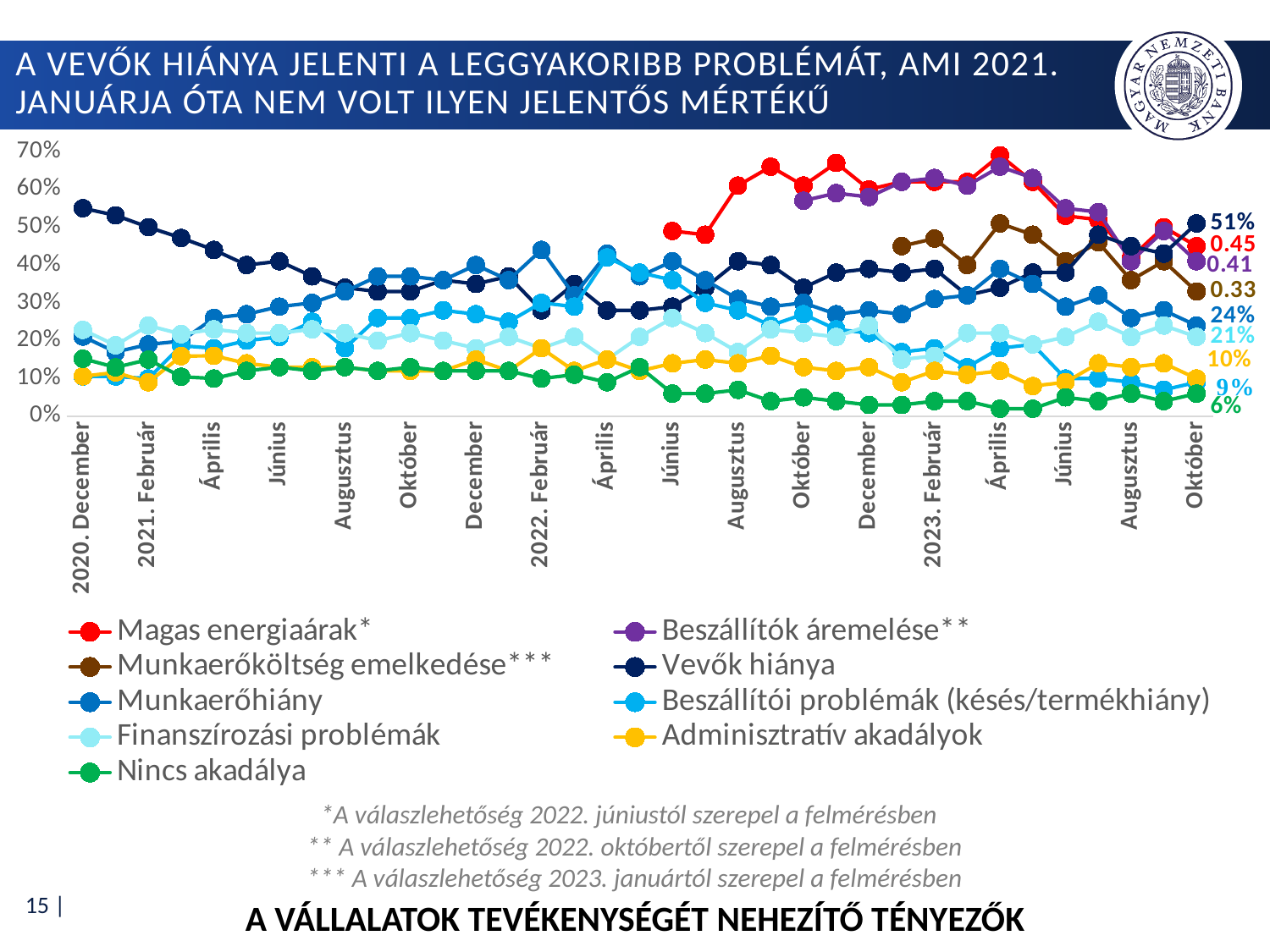
Which series has the highest value at the last point (October 2023)? Vevők hiánya What is the final data label shown for the 'Beszállítók áremelése**' series? 0.41 What is the final (October 2023) value shown for the 'Nincs akadálya' series? 6% Which series has the lowest value at the last point (October 2023)? Nincs akadálya How many series does the legend list? 9 What type of chart is shown on the slide? line chart Is the value for 'Vevők hiánya' in 2020. December greater or less than 50%? greater What is the final (October 2023) value shown for the 'Munkaerőhiány' series? 24% What is the final data label shown for the 'Munkaerőköltség emelkedése***' series? 0.33 What is the final data label shown for the 'Magas energiaárak*' series? 0.45 At the last point (October 2023), which is larger: 'Finanszírozási problémák' or 'Adminisztratív akadályok'? Finanszírozási problémák What is the final (October 2023) value shown for the 'Vevők hiánya' series? 51%